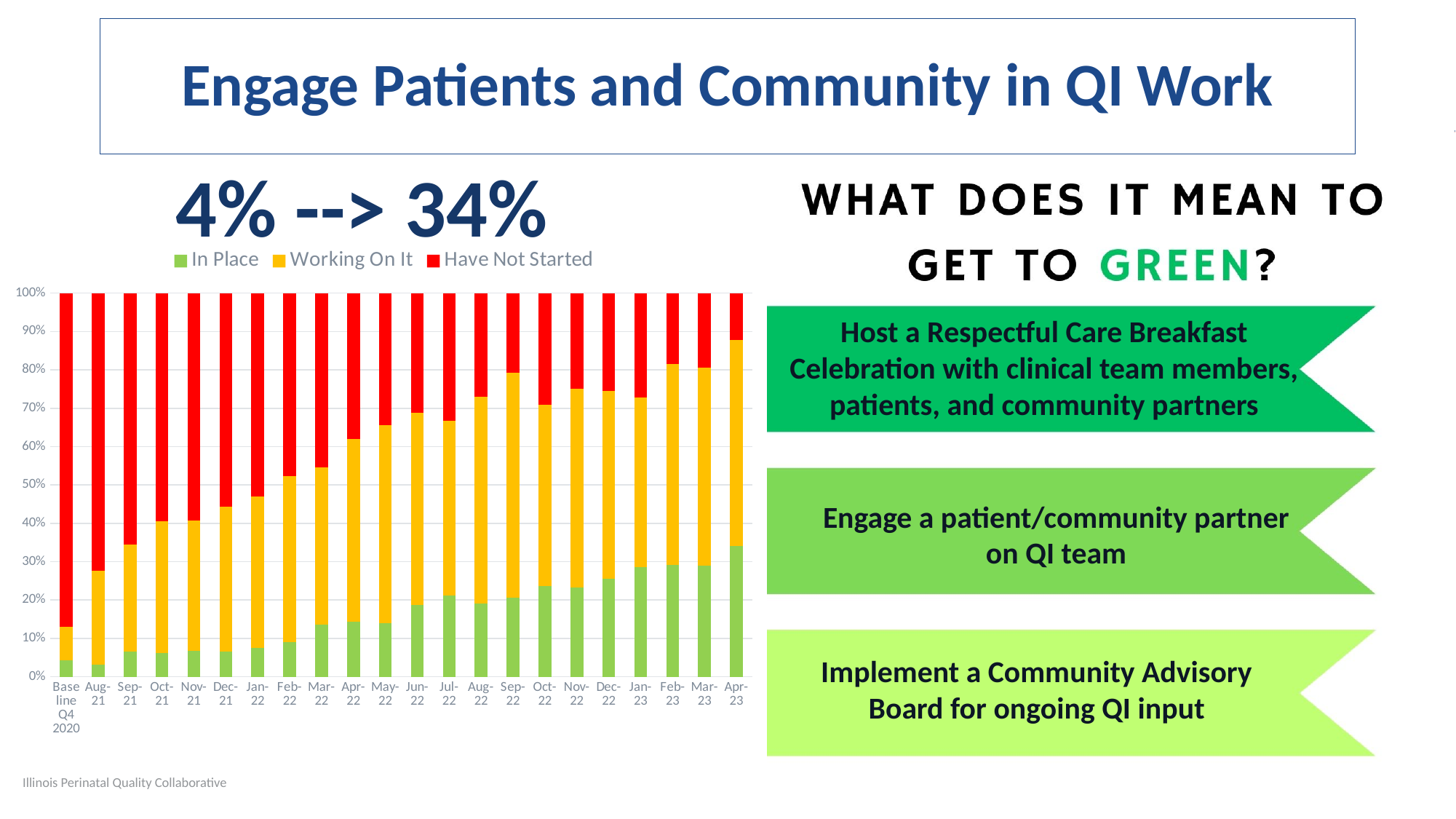
Which period has the largest 'Have Not Started' share? Baseline Q4 2020 Is the 'Have Not Started' share for the Baseline Q4 2020 bar greater or less than 80%? greater Does the 'In Place' share generally rise or fall from Baseline Q4 2020 to Apr-23? Rise According to the headline above the chart, what is the 'In Place' percentage in Apr-23? 34% According to the headline above the chart, what was the 'In Place' percentage at baseline? 4% Which colour represents the 'Have Not Started' series in the chart? Red Which period has the largest 'In Place' share? Apr-23 How many time periods (bars) are shown along the x axis of the chart? 22 How many series does the chart legend list? 3 What kind of chart is shown on the slide? Stacked bar chart Is the 'In Place' value for Apr-23 greater or less than 30%? greater What are the three series named in the chart legend? In Place, Working On It, Have Not Started